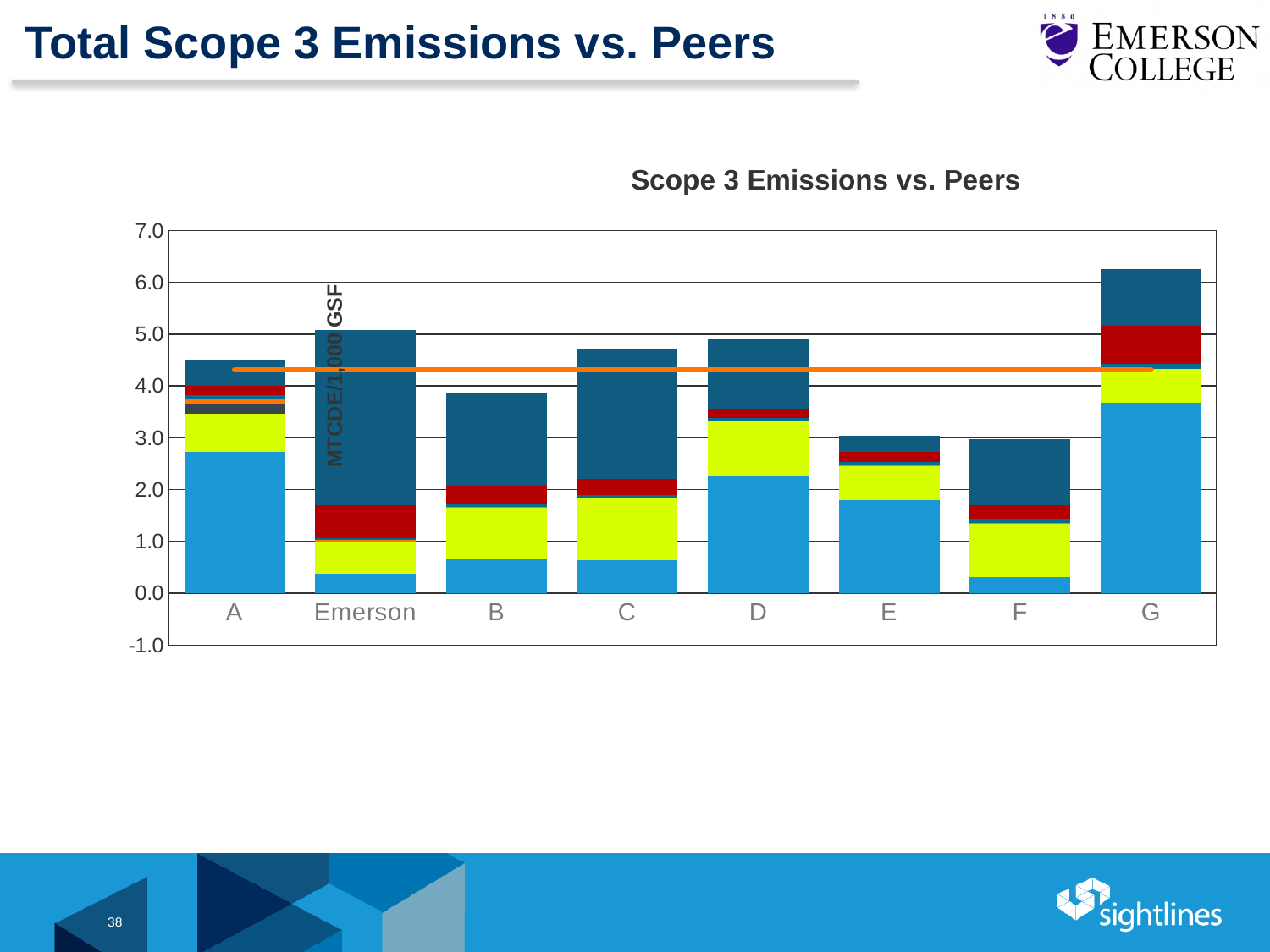
What is the title of the chart? Scope 3 Emissions vs. Peers Is the total value for C greater or less than 4.0? greater Which has a larger total Scope 3 emissions value, D or E? D Which has a larger total Scope 3 emissions value, B or C? C How many institutions (bars) are shown on the x axis of the chart? 8 Is the total value for B greater or less than 4.0? less Is the total value for D greater or less than 5.0? less What unit is shown on the vertical axis label of the chart? MTCDE/1,000 GSF Which institution has the highest total Scope 3 emissions in the chart? G What type of chart is shown on the slide? Stacked bar chart